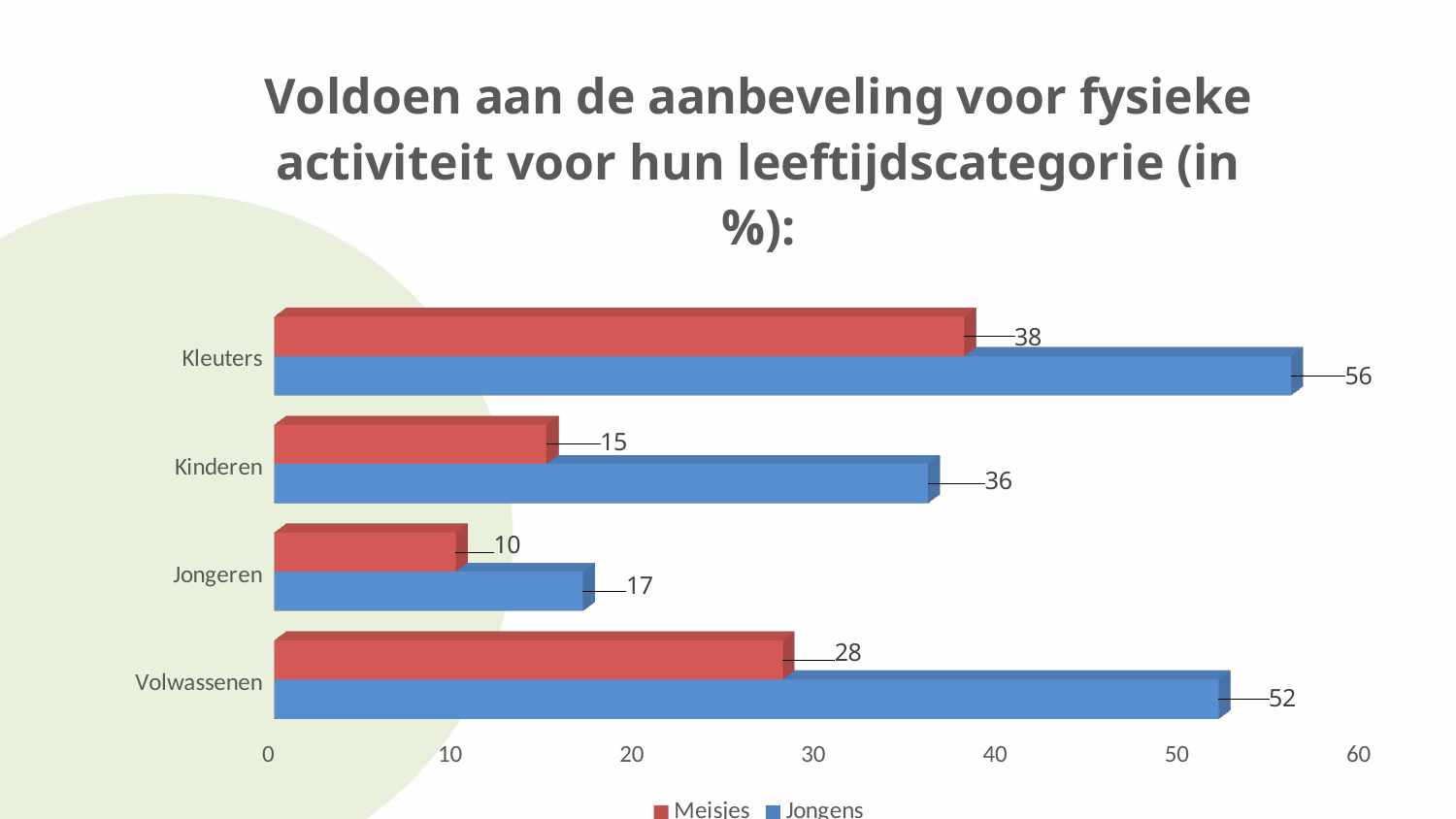
What is the value for Jongens in the Volwassenen category? 52 Which category has the lowest value for Meisjes? Jongeren What kind of chart is shown on the slide? bar chart How many series does the legend list? 2 Which category has the highest value for Jongens? Kleuters What is the value for Jongens in the Kleuters category? 56 Which is larger: the Meisjes value for Kleuters or the Meisjes value for Volwassenen? Kleuters Which colour represents the Meisjes series? red What is the difference between the Jongens and Meisjes values for Kinderen? 21 Is the value for Jongens in the Jongeren category greater or less than 20? less What is the value for Meisjes in the Kinderen category? 15 How many categories are shown on the chart? 4